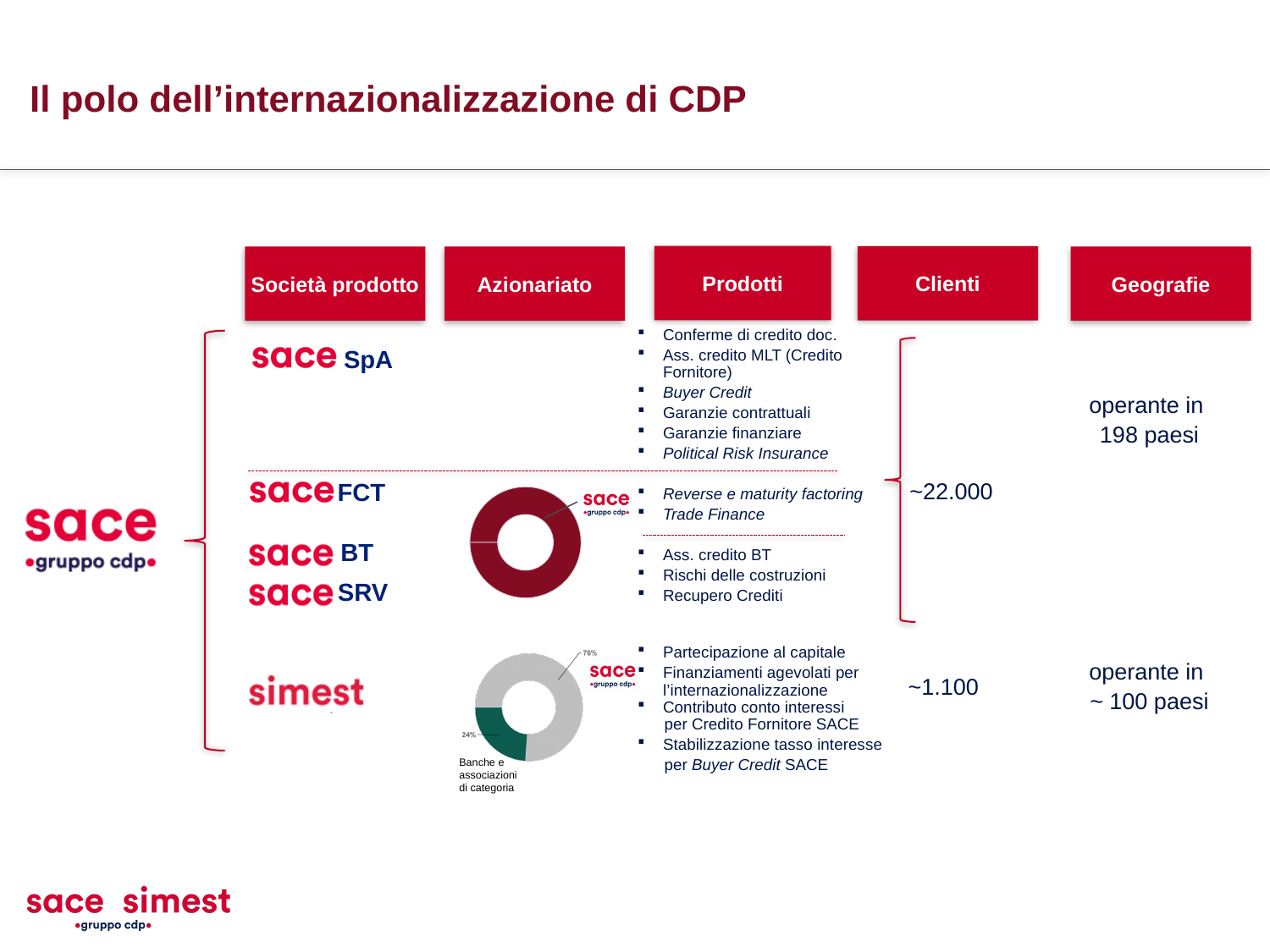
How many slices does the simest shareholding chart have? 2 How many slices does the shareholding chart for SACE FCT, SACE BT and SACE SRV have? 1 In the simest shareholding chart, which shareholder holds the smallest share? Banche e associazioni di categoria In the simest shareholding chart, what share is held by SACE? 76% In the simest shareholding chart, is the SACE share larger or smaller than the Banche e associazioni di categoria share? larger How many pie charts are shown in the Azionariato column of the slide? 2 In the simest shareholding chart, which shareholder holds the largest share? SACE In the simest shareholding chart, what share is held by Banche e associazioni di categoria? 24% In the simest shareholding chart, what do the two printed shares add up to? 100% In the simest shareholding chart, what is the difference between the SACE share and the Banche e associazioni di categoria share? 52 percentage points In the simest shareholding chart, what colour is the 24% slice? green In the Azionariato column, what kind of chart is used to show the shareholding of simest? doughnut chart